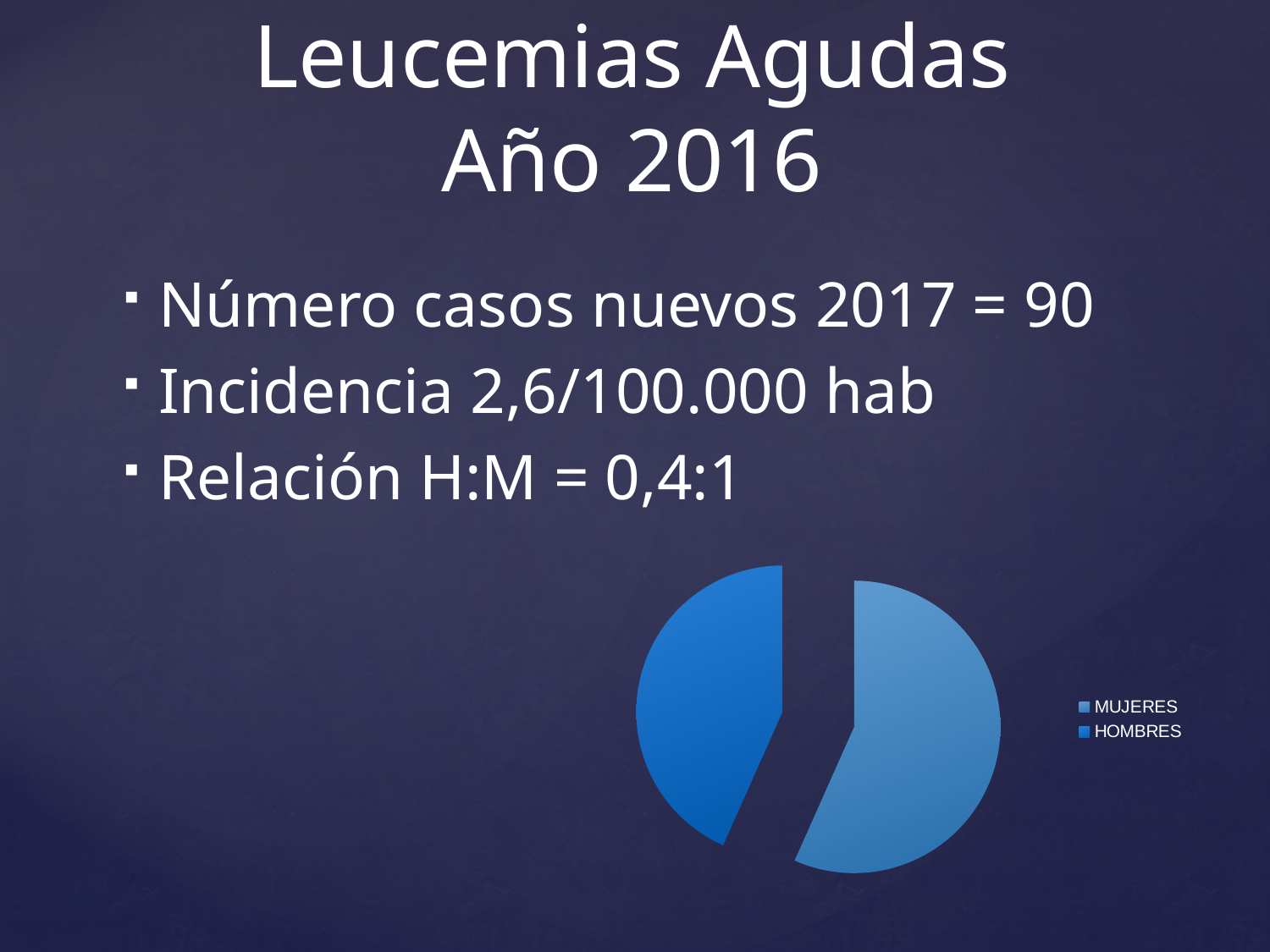
Which legend entry is listed first in the pie chart's legend? MUJERES How many entries does the legend of the pie chart list? 2 Which slice of the pie chart is the smallest? HOMBRES Which slice is larger in the pie chart, MUJERES or HOMBRES? MUJERES Which slice of the pie chart is the largest? MUJERES Which slice of the pie chart is drawn in the darker blue? HOMBRES How many slices does the pie chart have? 2 What kind of chart is shown on the slide? pie chart